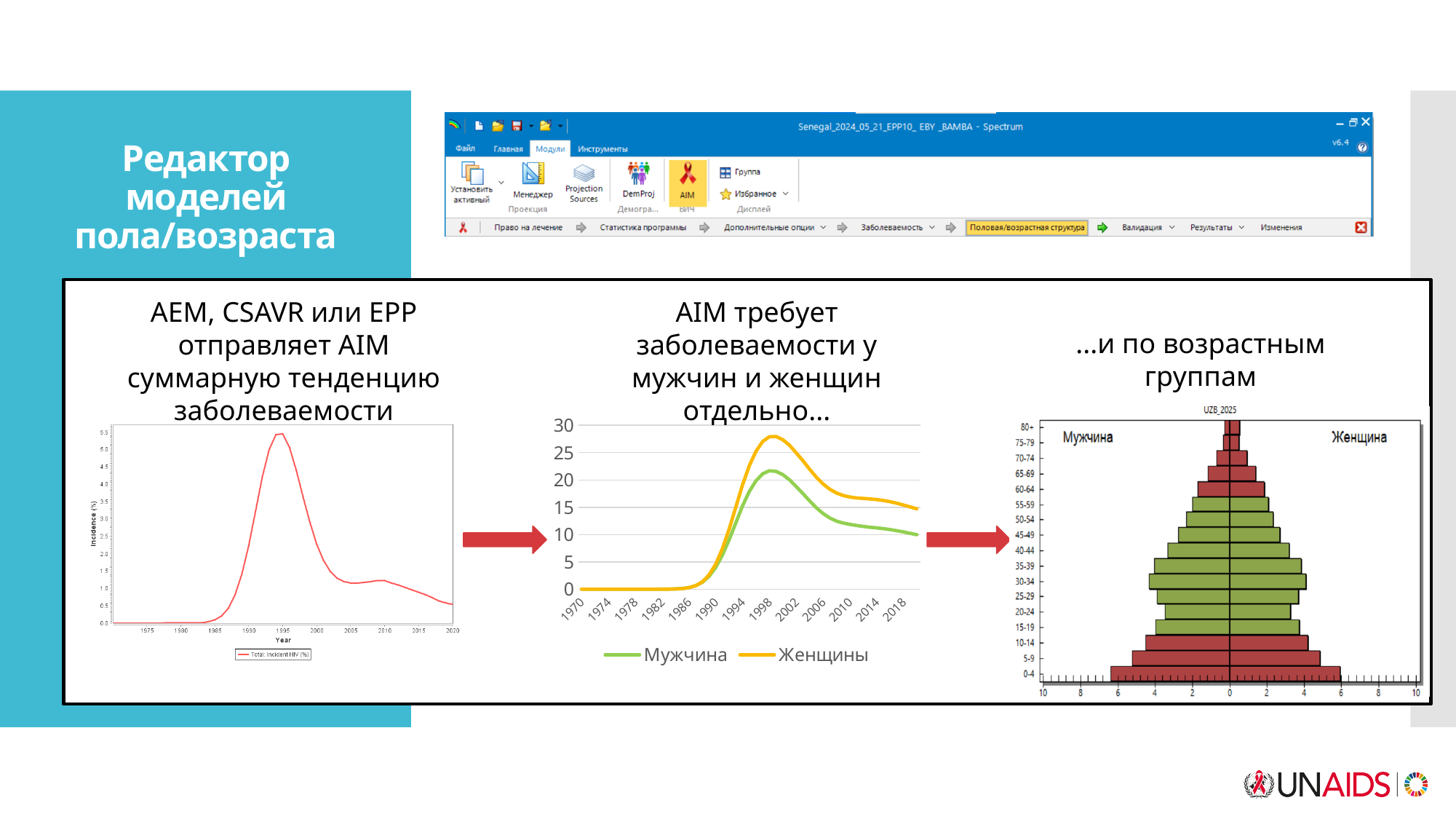
In the left chart, is the value of the Total: Incident HIV (%) line in 2020 greater or less than 1? less In the middle chart, do the values of the Женщины series rise or fall between 1998 and 2018? fall In the middle chart, what is the first year label on the x axis? 1970 In the middle chart, is the peak value of the Мужчина series greater or less than 25? less What kind of chart is the middle chart with the Мужчина and Женщины series? Line chart In the right chart titled UZB_2025, which age group has the widest bars? 0-4 In the middle chart, how many series does the legend list? 2 In the middle chart, what are the two series named in the legend? Мужчина and Женщины In the left chart, is the peak value of the Total: Incident HIV (%) line greater or less than 5? greater In the middle chart, which series is higher in 2018, Мужчина or Женщины? Женщины In the right chart titled UZB_2025, how many age groups are shown on the vertical axis? 17